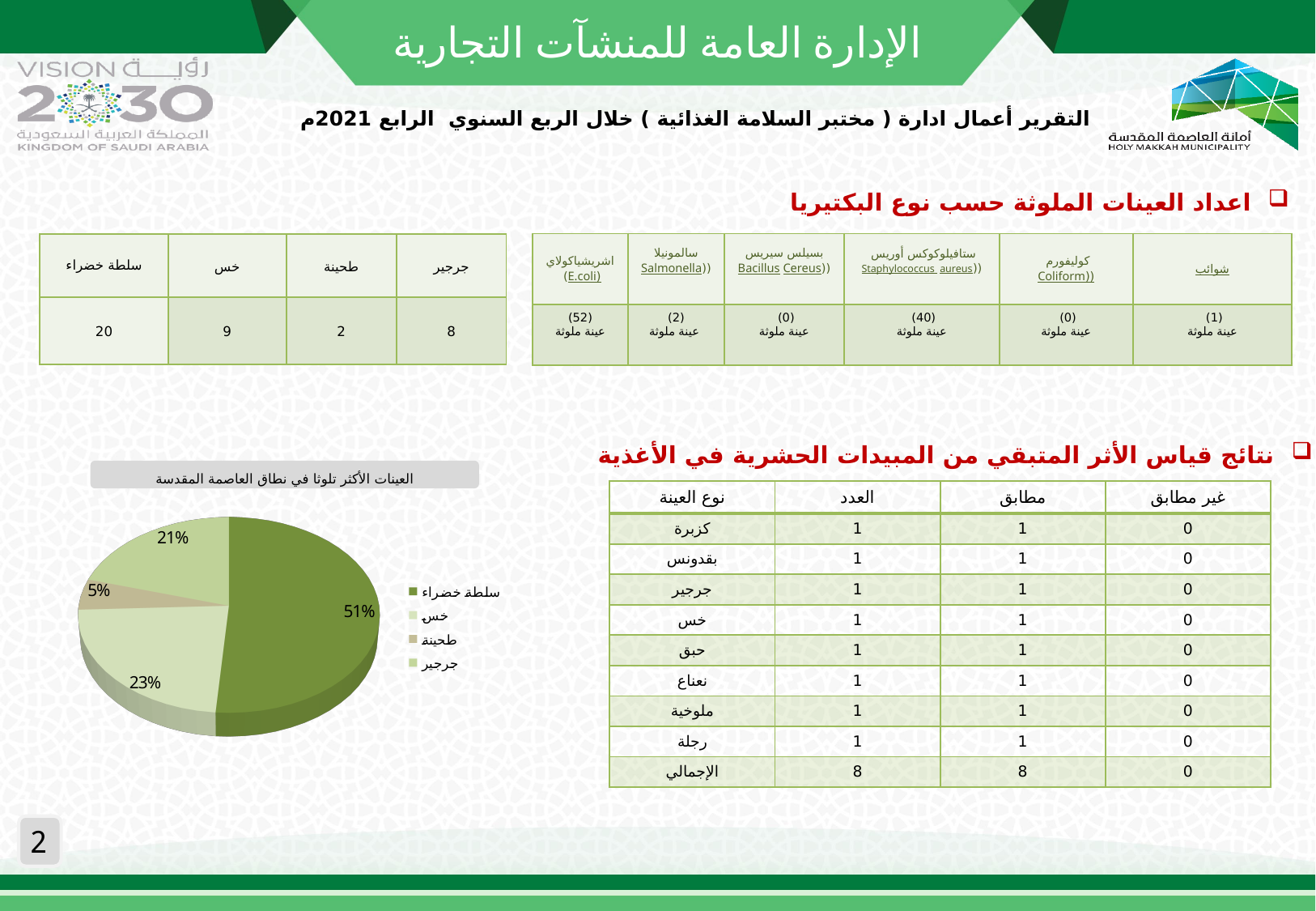
What share of the pie chart does طحينة represent? 5% In the pie chart, what is the difference in percentage points between the share for سلطة خضراء and the share for خس? 28% What kind of chart is shown on the slide? pie chart How many slices does the pie chart have? 4 In the pie chart, which is larger: the share for خس or the share for جرجير? خس Which category has the smallest slice in the pie chart? طحينة What share of the pie chart does خس represent? 23% What is the title of the pie chart? العينات الأكثر تلوثا في نطاق العاصمة المقدسة What share of the pie chart does سلطة خضراء represent? 51% How many entries does the pie chart's legend list? 4 Which category has the largest slice in the pie chart? سلطة خضراء